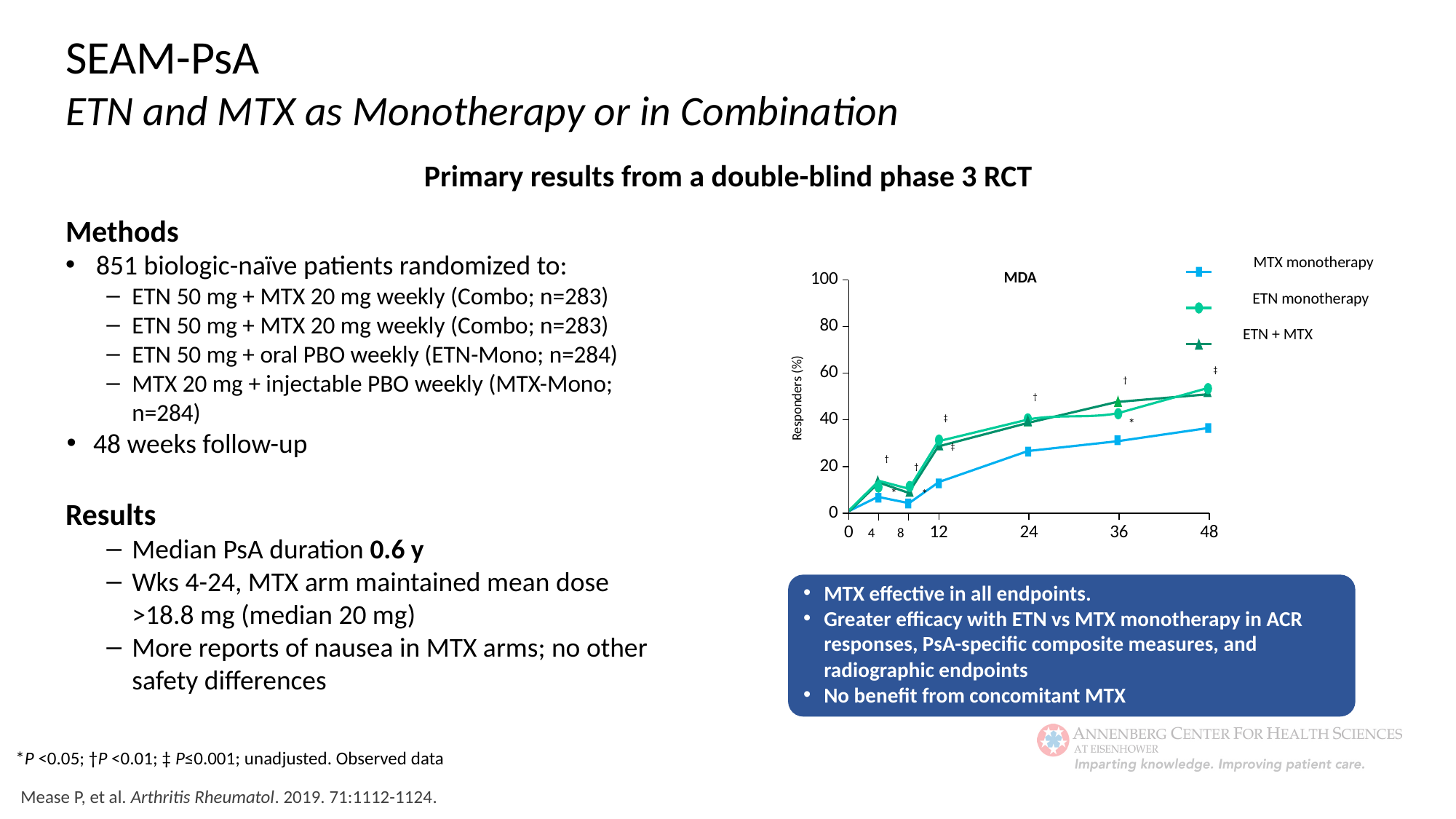
In the MDA chart, is the value for ETN + MTX at week 36 greater or less than 40? greater How many time points are marked on the x axis of the MDA chart? 7 What is the title of the chart on the slide? MDA In the MDA chart, is the value for MTX monotherapy at week 48 greater or less than 40? less In the MDA chart, at week 48, which is larger: MTX monotherapy or ETN monotherapy? ETN monotherapy In the MDA chart, is the value for MTX monotherapy at week 12 greater or less than 20? less How many series does the legend of the MDA chart list? 3 What is the y-axis label of the MDA chart? Responders (%) In the MDA chart, do the MTX monotherapy values rise or fall from week 0 to week 48? rise What kind of chart is shown on the slide? line chart In the MDA chart, which series has the lowest value at week 48? MTX monotherapy